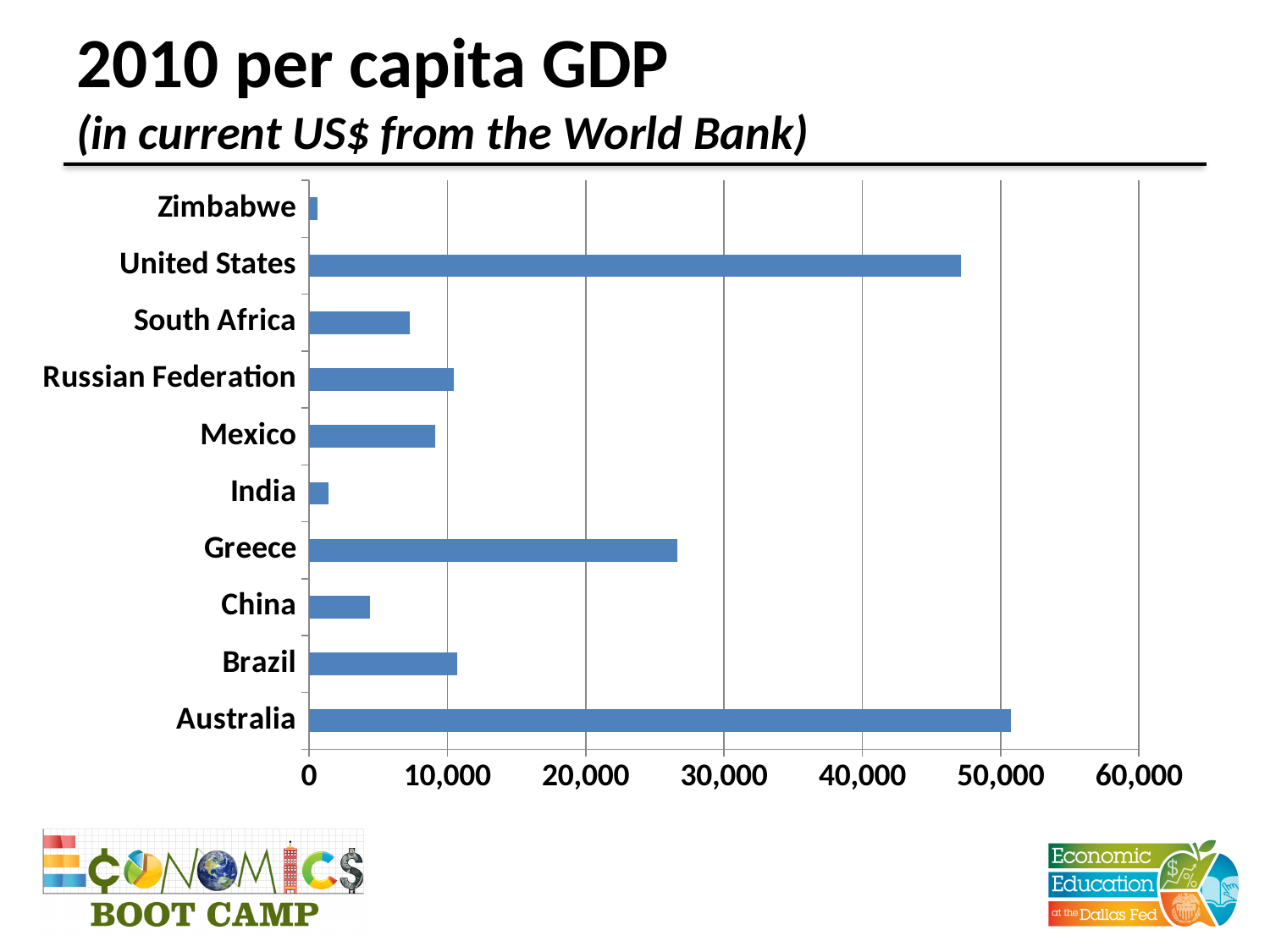
Is the value for China greater or less than 10,000? less Which country has the lowest 2010 per capita GDP in the chart? Zimbabwe Which country has the highest 2010 per capita GDP in the chart? Australia Which has the larger per capita GDP, India or China? China Is the value for the United States greater or less than 40,000? greater Which has the larger per capita GDP, Greece or the Russian Federation? Greece Which has the larger per capita GDP, Mexico or South Africa? Mexico Is the value for Australia greater or less than 50,000? greater What is the title of the chart on the slide? 2010 per capita GDP (in current US$ from the World Bank) What kind of chart is shown on the slide? bar chart How many countries are shown in the chart? 10